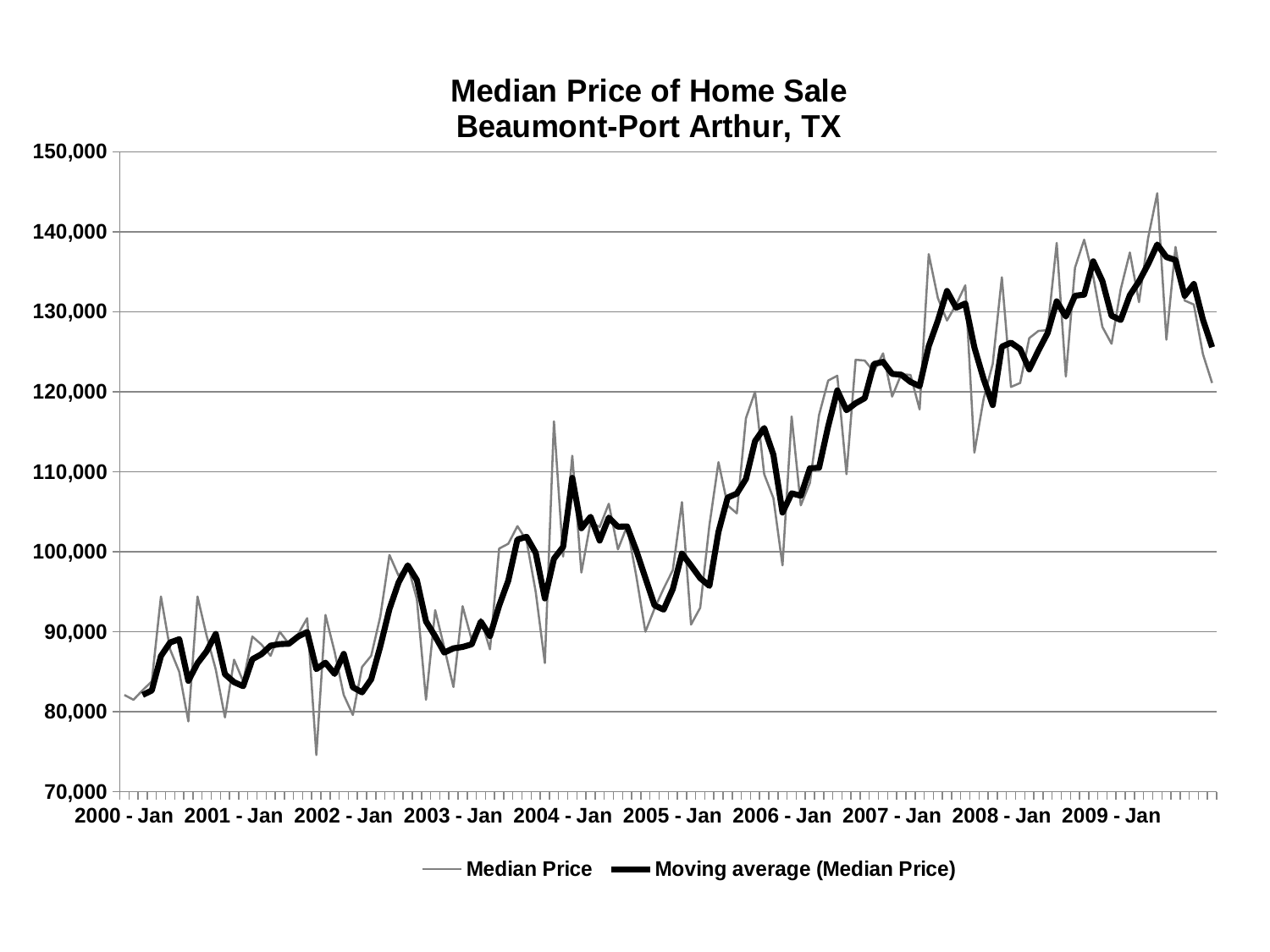
Which two series are listed in the chart legend? Median Price and Moving average (Median Price) Is the highest point of the Median Price line greater or less than 140,000? greater In which year does the Median Price line reach its highest point? 2009 Is the Median Price at 2000 - Jan greater or less than 90,000? less Is the Moving average (Median Price) at 2007 - Jan greater or less than 120,000? greater How many year labels are shown on the x axis? 10 What kind of chart is shown on the slide? line chart Which is higher, the Median Price at 2000 - Jan or the Median Price at 2009 - Jan? 2009 - Jan What is the title of the chart? Median Price of Home Sale Beaumont-Port Arthur, TX How many series does the legend list? 2 Overall, does the Median Price rise or fall from 2000 - Jan to 2009 - Jan? rise